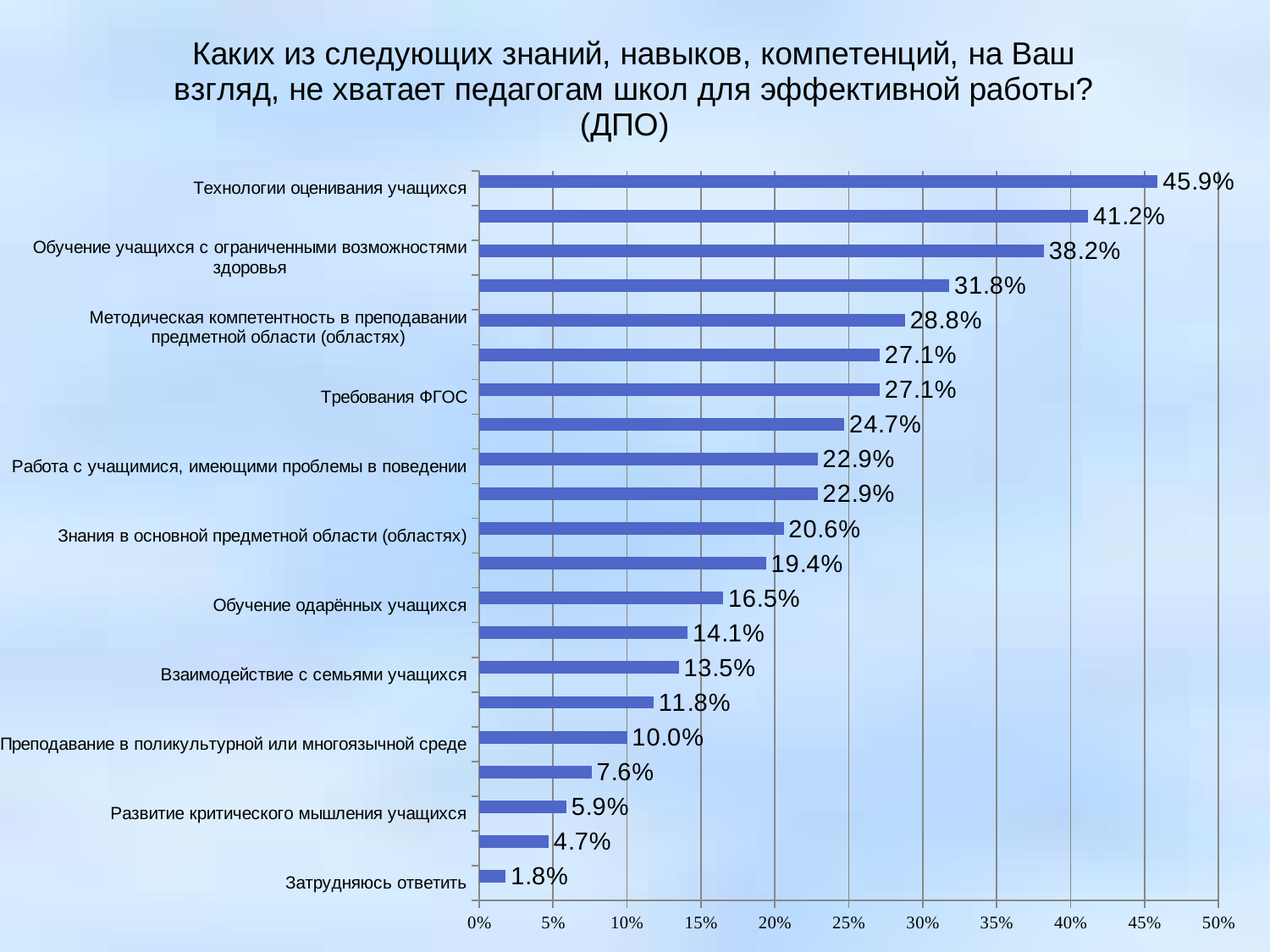
What is the difference between the values for Технологии оценивания учащихся and Обучение учащихся с ограниченными возможностями здоровья? 7.7% What is the value for Преподавание в поликультурной или многоязычной среде? 10.0% What is the value for Технологии оценивания учащихся? 45.9% What is the value for Обучение учащихся с ограниченными возможностями здоровья? 38.2% How many bars are plotted in the chart? 21 Which category has the highest value? Технологии оценивания учащихся What is the value for Затрудняюсь ответить? 1.8% Is the value for Развитие критического мышления учащихся greater or less than 10%? less Which category has the lowest value? Затрудняюсь ответить What kind of chart is shown on the slide? bar chart Which is larger: the value for Обучение одарённых учащихся or the value for Взаимодействие с семьями учащихся? Обучение одарённых учащихся What is the value for Требования ФГОС? 27.1%